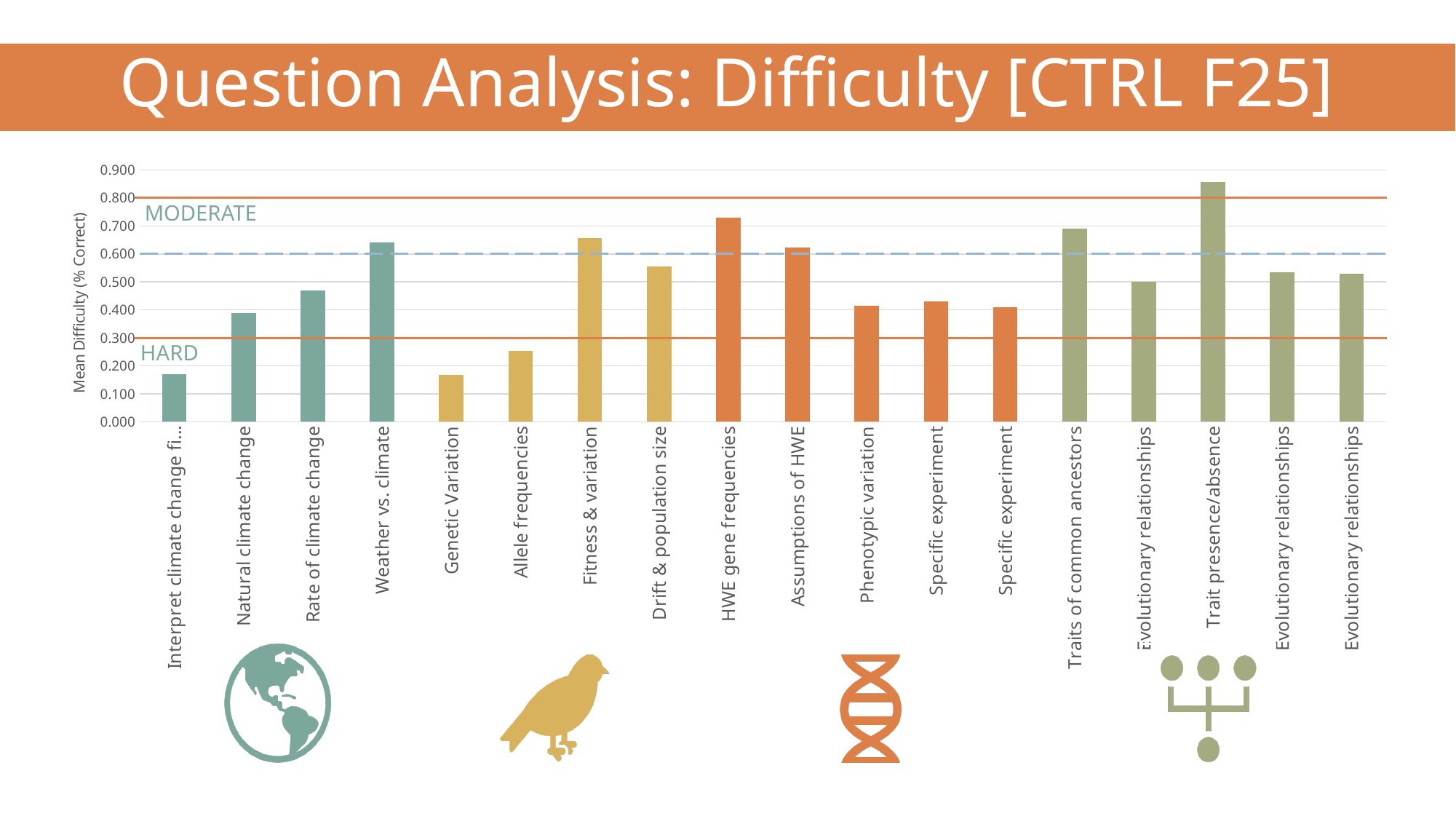
Is the value for Weather vs. climate greater or less than 0.600? greater Which category has the highest mean difficulty value? Trait presence/absence What is the label on the vertical axis of the chart? Mean Difficulty (% Correct) Is the value for Rate of climate change greater or less than 0.500? less What two difficulty band labels are written next to the horizontal reference lines on the chart? MODERATE and HARD Is the value for Allele frequencies greater or less than 0.300? less Which is larger, the value for HWE gene frequencies or the value for Assumptions of HWE? HWE gene frequencies What kind of chart is shown on the slide? bar chart How many bars (categories) are plotted in the chart? 18